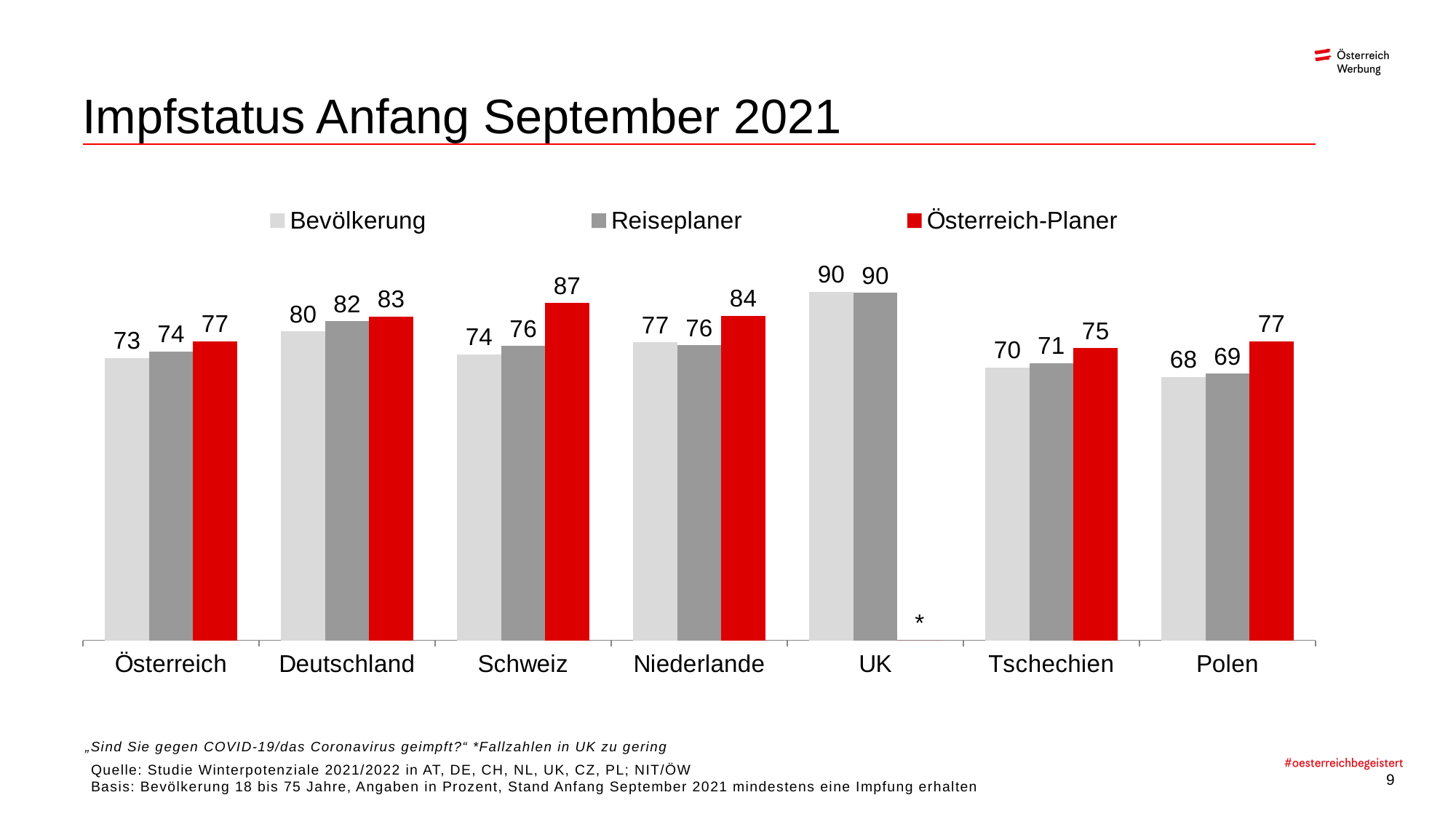
Which country has the lowest Österreich-Planer value? Tschechien Which country has no Österreich-Planer bar? UK What is the Bevölkerung value for Schweiz? 74 What kind of chart is shown on the slide? Bar chart What is the Österreich-Planer value for Niederlande? 84 What is the difference between the Österreich-Planer and Bevölkerung values for Polen? 9 What is the title of the slide? Impfstatus Anfang September 2021 Which is larger for Niederlande: the Bevölkerung value or the Reiseplaner value? Bevölkerung How many countries are shown on the x axis? 7 Which country has the highest Bevölkerung value? UK How many series does the legend list? 3 What is the Reiseplaner value for Tschechien? 71